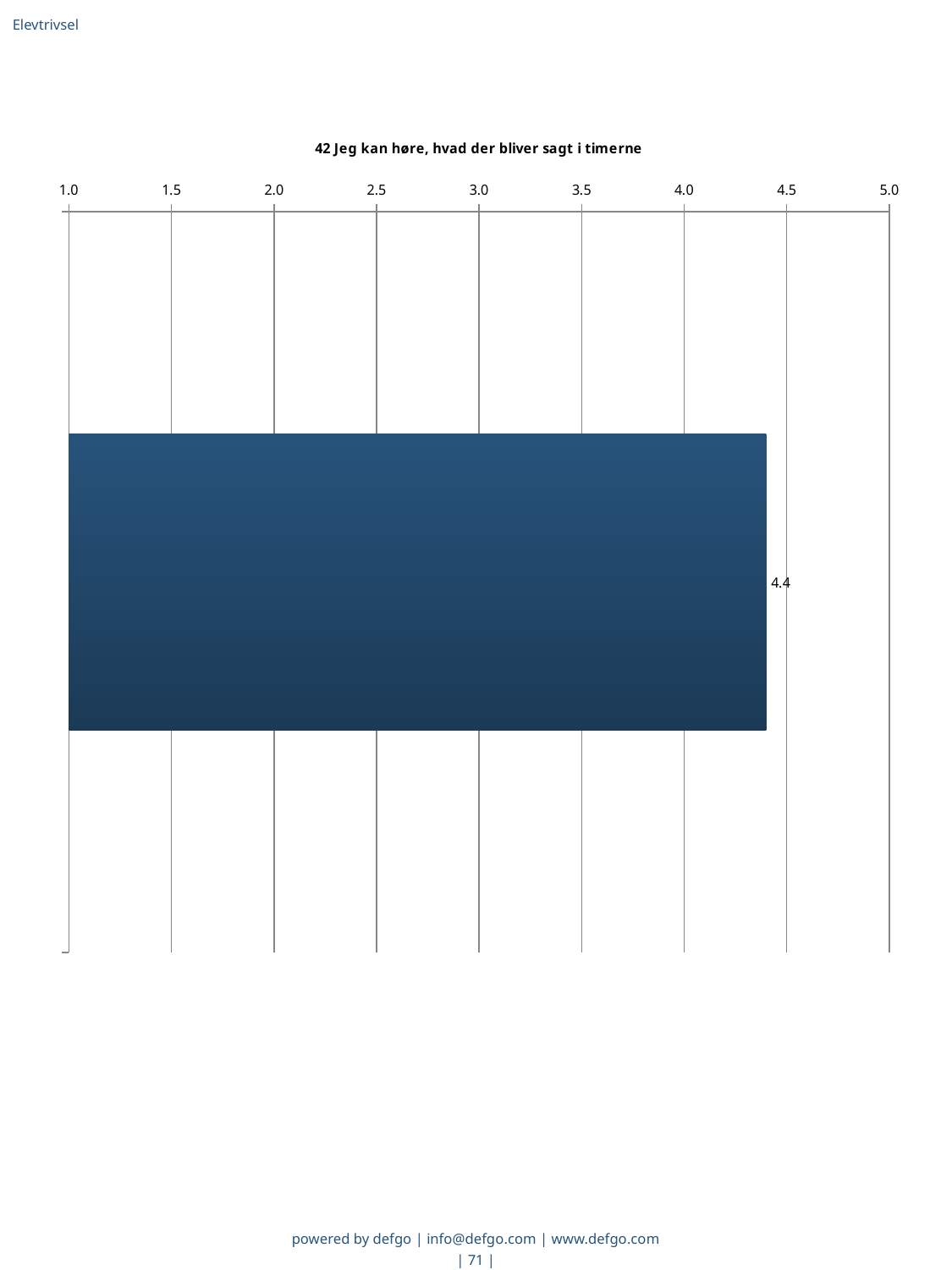
What kind of chart is shown on the slide? bar chart What is the title of the chart? 42 Jeg kan høre, hvad der bliver sagt i timerne How many bars are plotted in the chart? 1 Is the value of the bar greater or less than 4.5? less What is the value shown by the bar in the chart? 4.4 Is the bar in the chart horizontal or vertical? horizontal What is the maximum value shown on the chart's axis? 5.0 Is the value of the bar greater or less than 4.0? greater